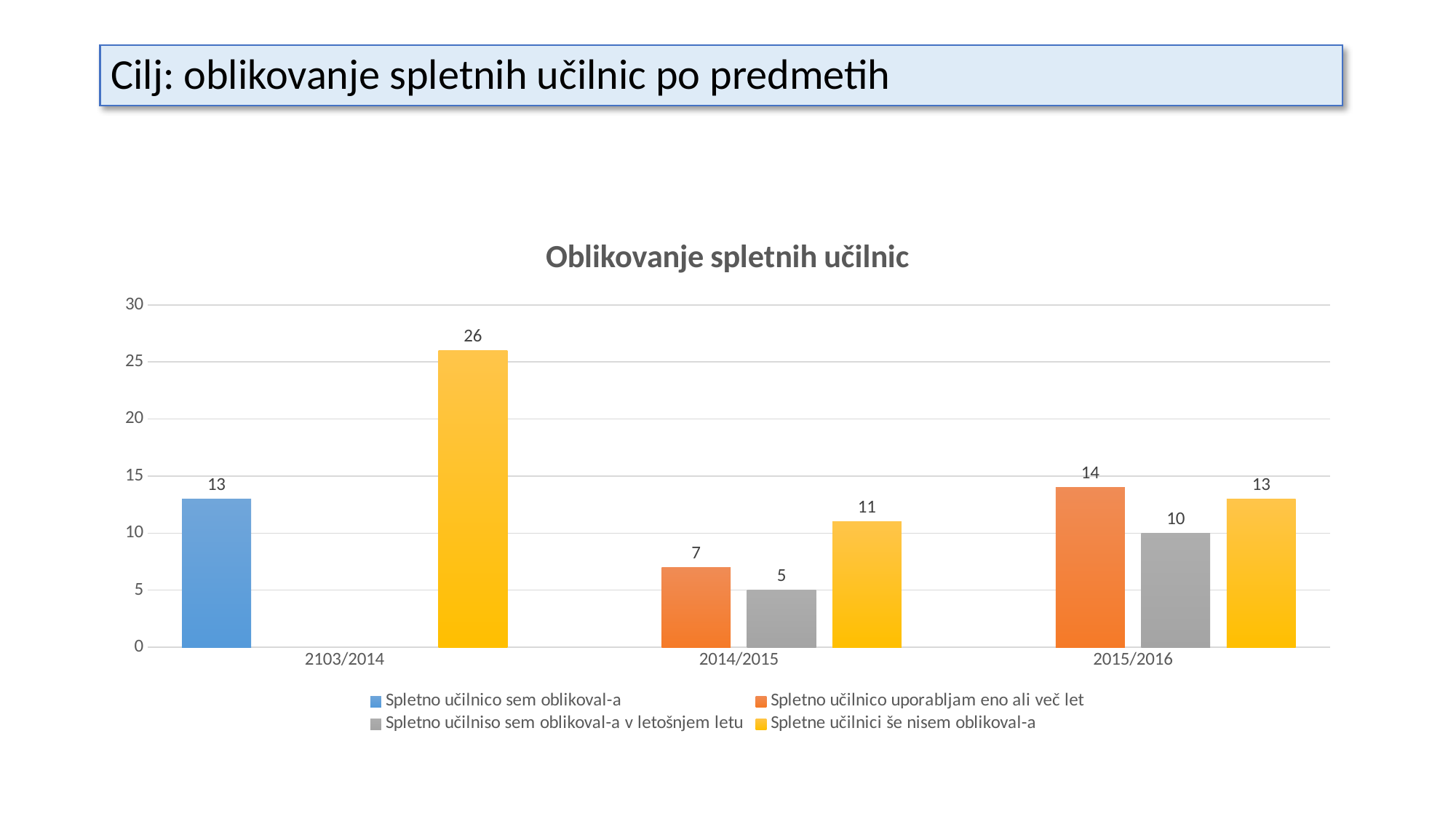
Which is larger in 2015/2016: 'Spletno učilnico uporabljam eno ali več let' or 'Spletno učilniso sem oblikoval-a v letošnjem letu'? Spletno učilnico uporabljam eno ali več let What is the title of the chart? Oblikovanje spletnih učilnic What is the value for 'Spletne učilnici še nisem oblikoval-a' in 2103/2014? 26 What is the value for 'Spletno učilniso sem oblikoval-a v letošnjem letu' in 2014/2015? 5 How many series does the legend list? 4 What is the value for 'Spletno učilnico uporabljam eno ali več let' in 2015/2016? 14 What type of chart is shown on the slide? bar chart Which category has the lowest value for 'Spletne učilnici še nisem oblikoval-a'? 2014/2015 What is the difference between the 'Spletne učilnici še nisem oblikoval-a' values for 2103/2014 and 2015/2016? 13 How many categories are shown on the x axis? 3 Which category has the highest value for 'Spletne učilnici še nisem oblikoval-a'? 2103/2014 Does the value for 'Spletno učilnico uporabljam eno ali več let' rise or fall from 2014/2015 to 2015/2016? rise